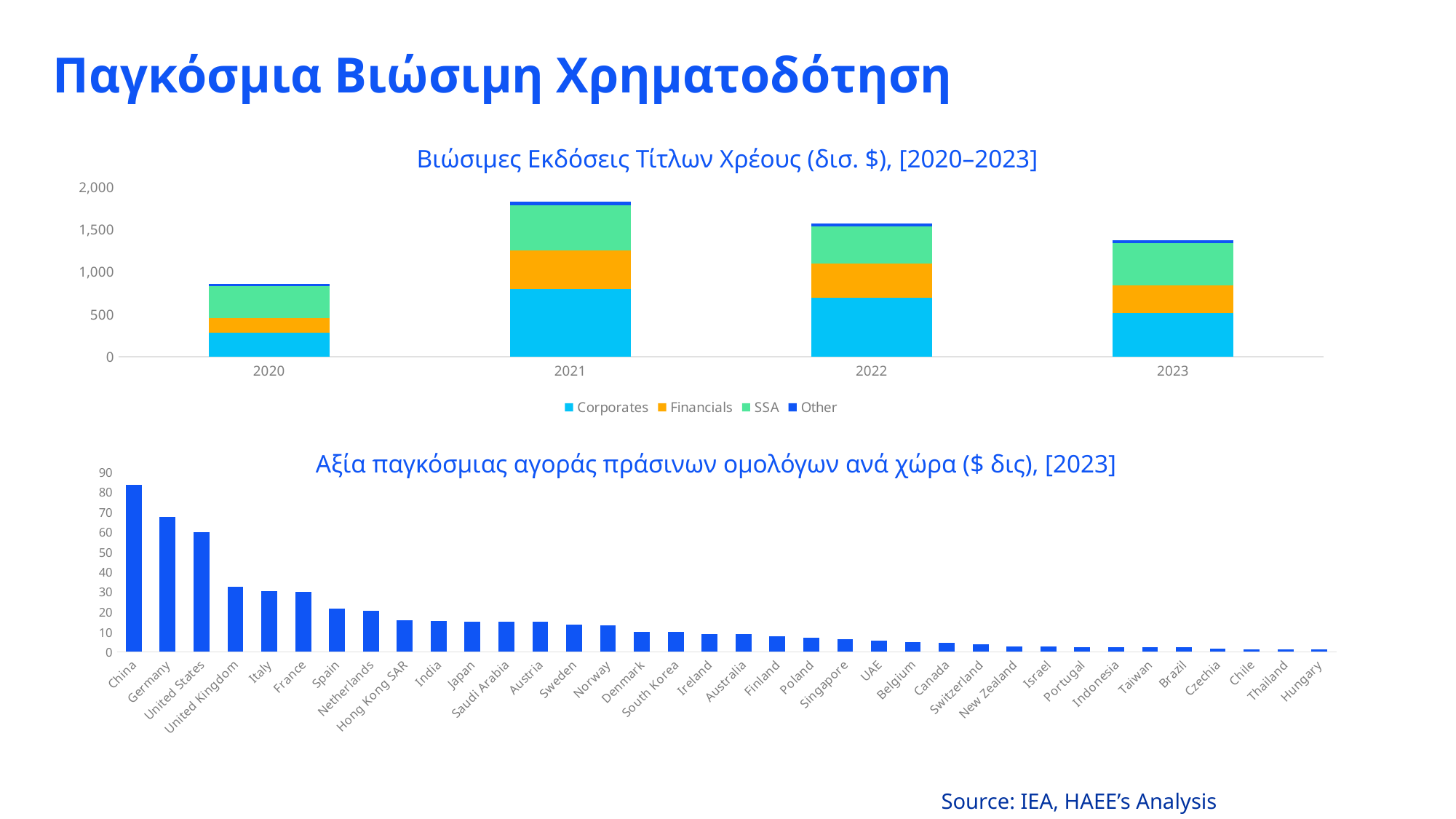
How many series does the legend of the top chart list? 4 In the top chart, is the total for 2021 greater or less than 1,500? greater How many years are shown on the x axis of the top chart? 4 In the top chart, which year has the larger total: 2022 or 2023? 2022 What kind of chart is the top chart, 'Βιώσιμες Εκδόσεις Τίτλων Χρέους (δισ. $), [2020–2023]'? Stacked bar chart In the top chart, which year has the lowest total sustainable debt issuance? 2020 In the bottom chart, is the value for China greater or less than 80? greater In the bottom chart, do the values rise or fall from left to right along the x axis? Fall In the bottom chart, which country has the larger value: Germany or United States? Germany In the top chart, is the total for 2020 greater or less than 1,000? less In the bottom chart, 'Αξία παγκόσμιας αγοράς πράσινων ομολόγων ανά χώρα ($ δις), [2023]', which country has the highest value? China In the top chart, which year has the highest total sustainable debt issuance? 2021